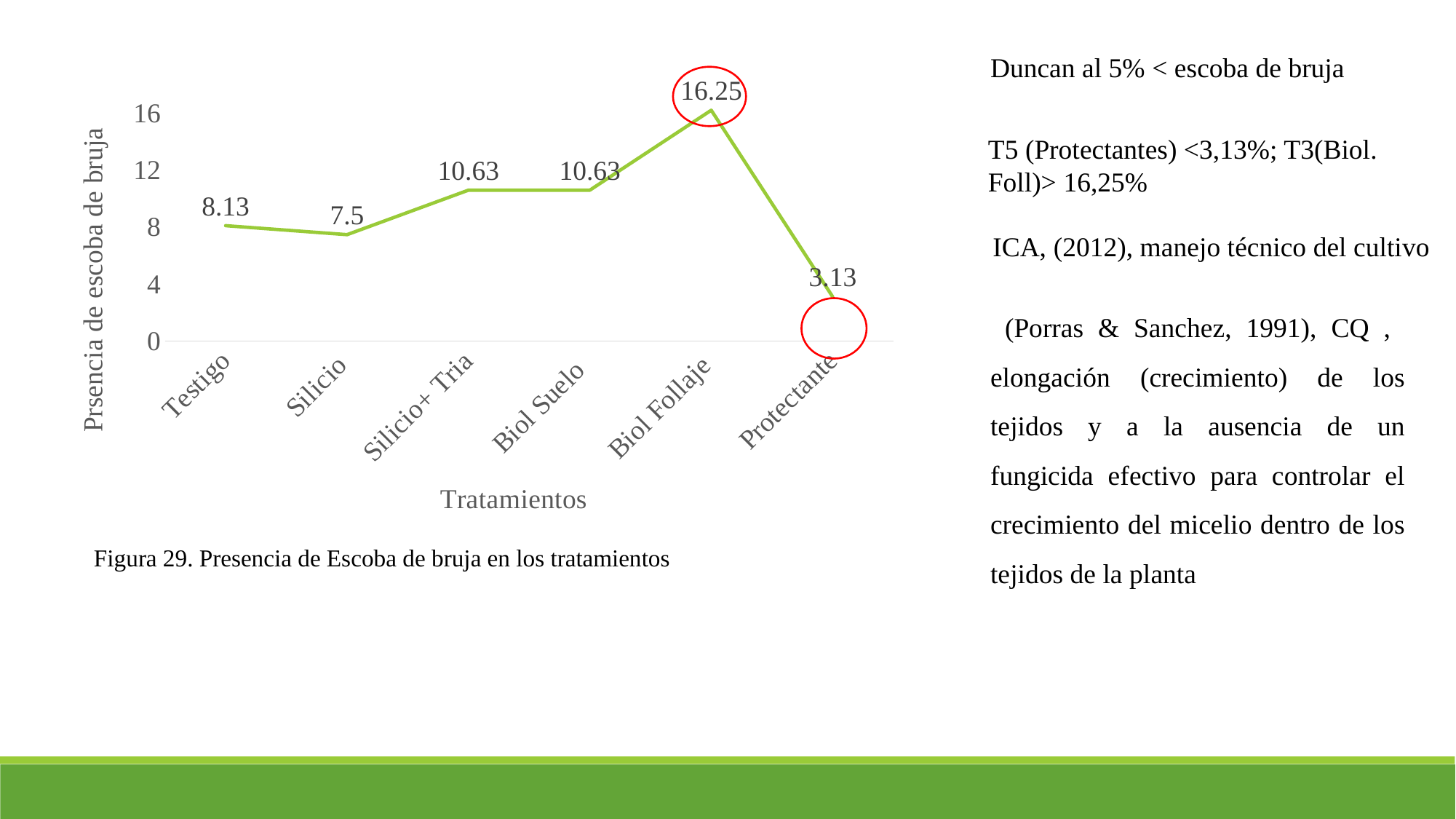
Which is larger, the value for Testigo or the value for Silicio? Testigo What is the value for Biol Follaje? 16.25 Is the value for Biol Suelo greater or less than 8? greater What is the value for Protectante? 3.13 How many treatments are plotted on the x axis? 6 What kind of chart is shown? line chart What is the difference between the values for Biol Follaje and Protectante? 13.12 Which treatment has the highest presence of escoba de bruja? Biol Follaje What is the value for Silicio? 7.5 What is the value for Testigo? 8.13 Which treatment has the lowest presence of escoba de bruja? Protectante What is the label of the x axis? Tratamientos